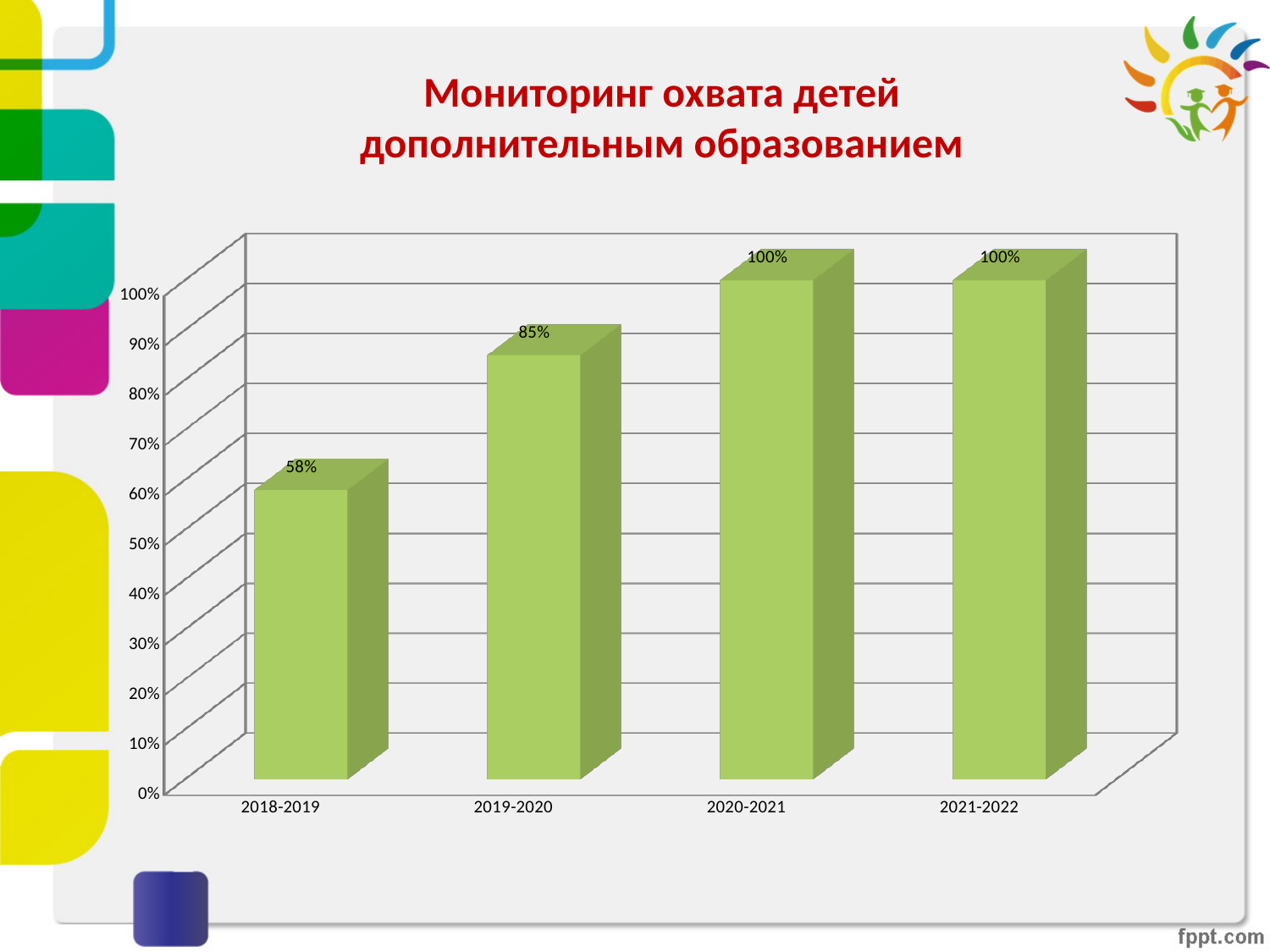
What is the value for 2020-2021? 100% What kind of chart is shown on the slide? bar chart Do the values rise or fall from 2018-2019 to 2020-2021? rise How many categories are shown on the x axis? 4 What is the value for 2021-2022? 100% What is the difference between the values for 2019-2020 and 2018-2019? 27% Which category has the lowest value? 2018-2019 Which is larger, the value for 2018-2019 or the value for 2019-2020? 2019-2020 What is the difference between the values for 2020-2021 and 2019-2020? 15% What is the value for 2019-2020? 85% What is the value for 2018-2019? 58% Is the value for 2018-2019 greater or less than 50%? greater